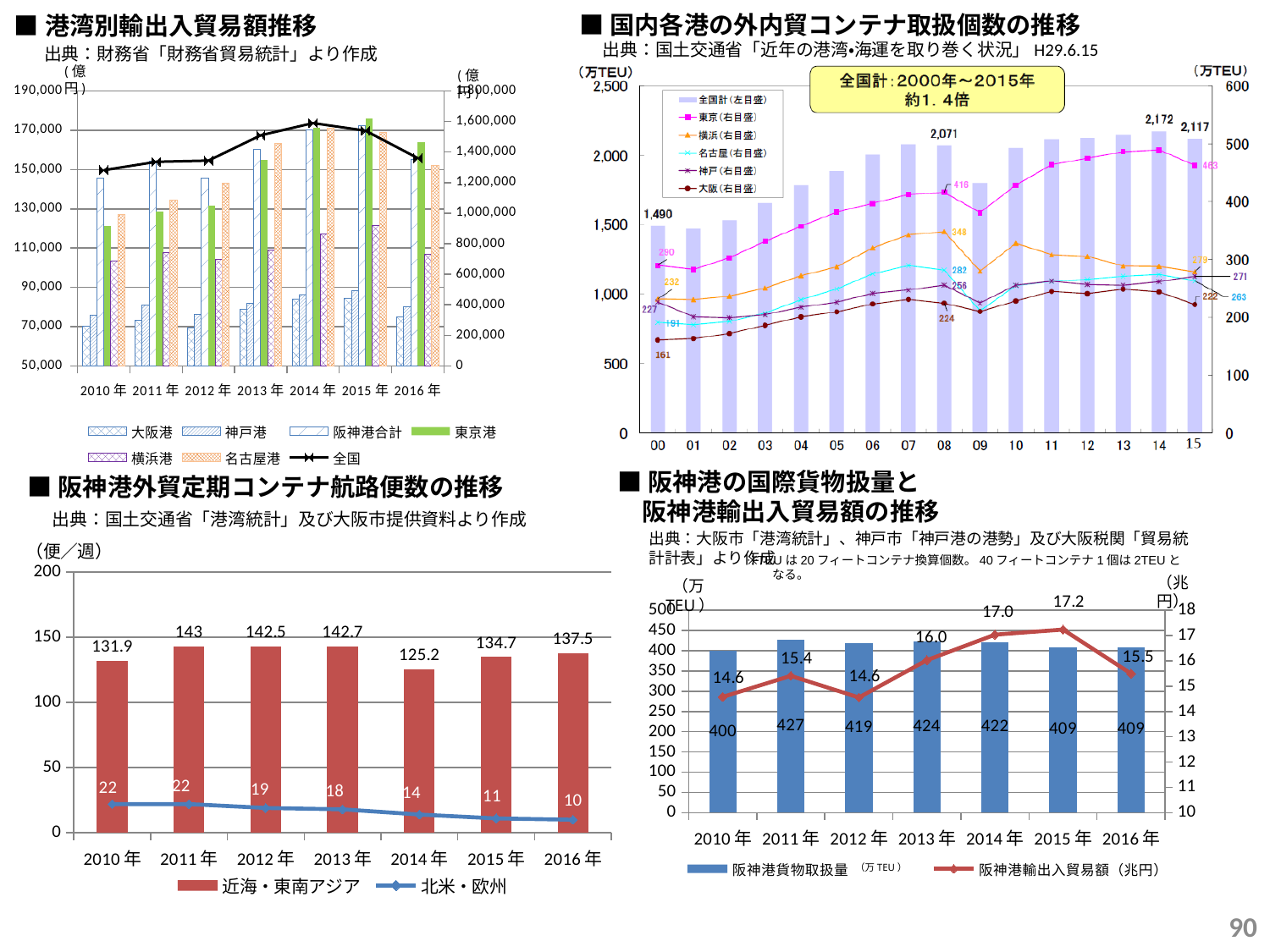
In the top-right chart (国内各港の外内貿コンテナ取扱個数の推移), what is the labelled value of 全国計 for 2014? 2,172 In the bottom-right chart (阪神港の国際貨物扱量と阪神港輸出入貿易額の推移), how many years are shown on the x axis? 7 In the bottom-left chart (阪神港外貿定期コンテナ航路便数の推移), what is the difference between the 近海・東南アジア values for 2011年 and 2010年? 11.1 In the bottom-right chart (阪神港の国際貨物扱量と阪神港輸出入貿易額の推移), what is the difference between the 阪神港輸出入貿易額 values for 2015年 and 2016年? 1.7 In the bottom-right chart (阪神港の国際貨物扱量と阪神港輸出入貿易額の推移), what is the value of 阪神港貨物取扱量 in 2011年? 427 In the top-left chart (港湾別輸出入貿易額推移), how many series does the legend list? 7 In the bottom-left chart (阪神港外貿定期コンテナ航路便数の推移), which year has the lowest value for 近海・東南アジア? 2014年 In the bottom-right chart (阪神港の国際貨物扱量と阪神港輸出入貿易額の推移), which year has the highest 阪神港輸出入貿易額? 2015年 In the bottom-left chart (阪神港外貿定期コンテナ航路便数の推移), what is the value for 北米・欧州 in 2016年? 10 In the top-right chart (国内各港の外内貿コンテナ取扱個数の推移), how many series does the legend list? 6 In the bottom-left chart (阪神港外貿定期コンテナ航路便数の推移), does the 北米・欧州 line rise or fall from 2010年 to 2016年? fall In the bottom-left chart (阪神港外貿定期コンテナ航路便数の推移), what is the value for 近海・東南アジア in 2011年? 143